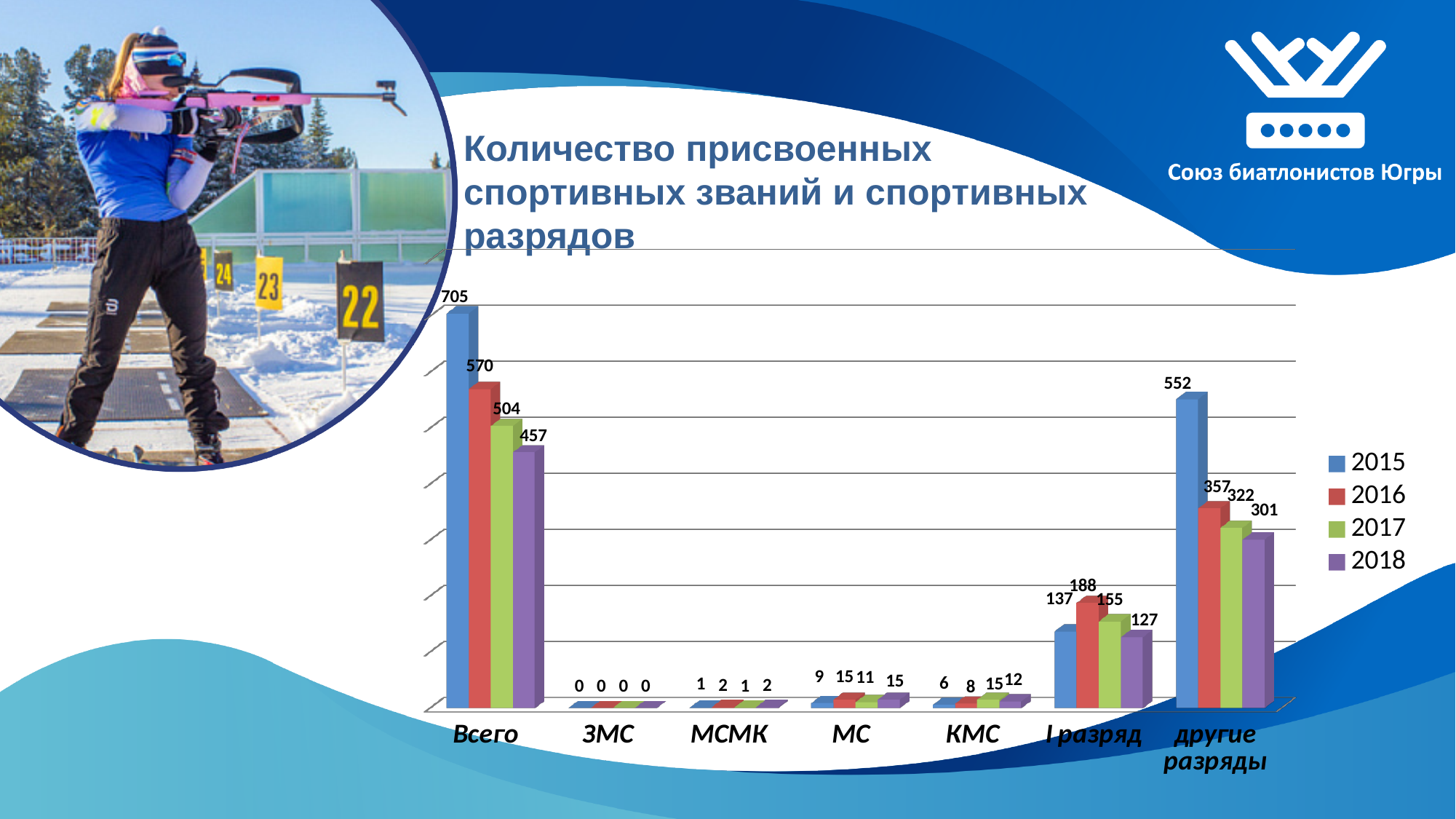
Which is larger: the 2016 value for МС or the 2016 value for КМС? МС (15) What is the value for I разряд in 2016? 188 What is the difference between the 2015 and 2016 values for другие разряды? 195 What is the value for Всего in 2015? 705 Which year has the highest value for Всего? 2015 Do the values for Всего rise or fall from 2015 to 2018? Fall Which year has the lowest value for I разряд? 2018 What is the value for другие разряды in 2018? 301 How many categories are shown on the x axis? 7 How many series does the legend list? 4 What kind of chart is shown on the slide? Bar chart What is the value for КМС in 2017? 15